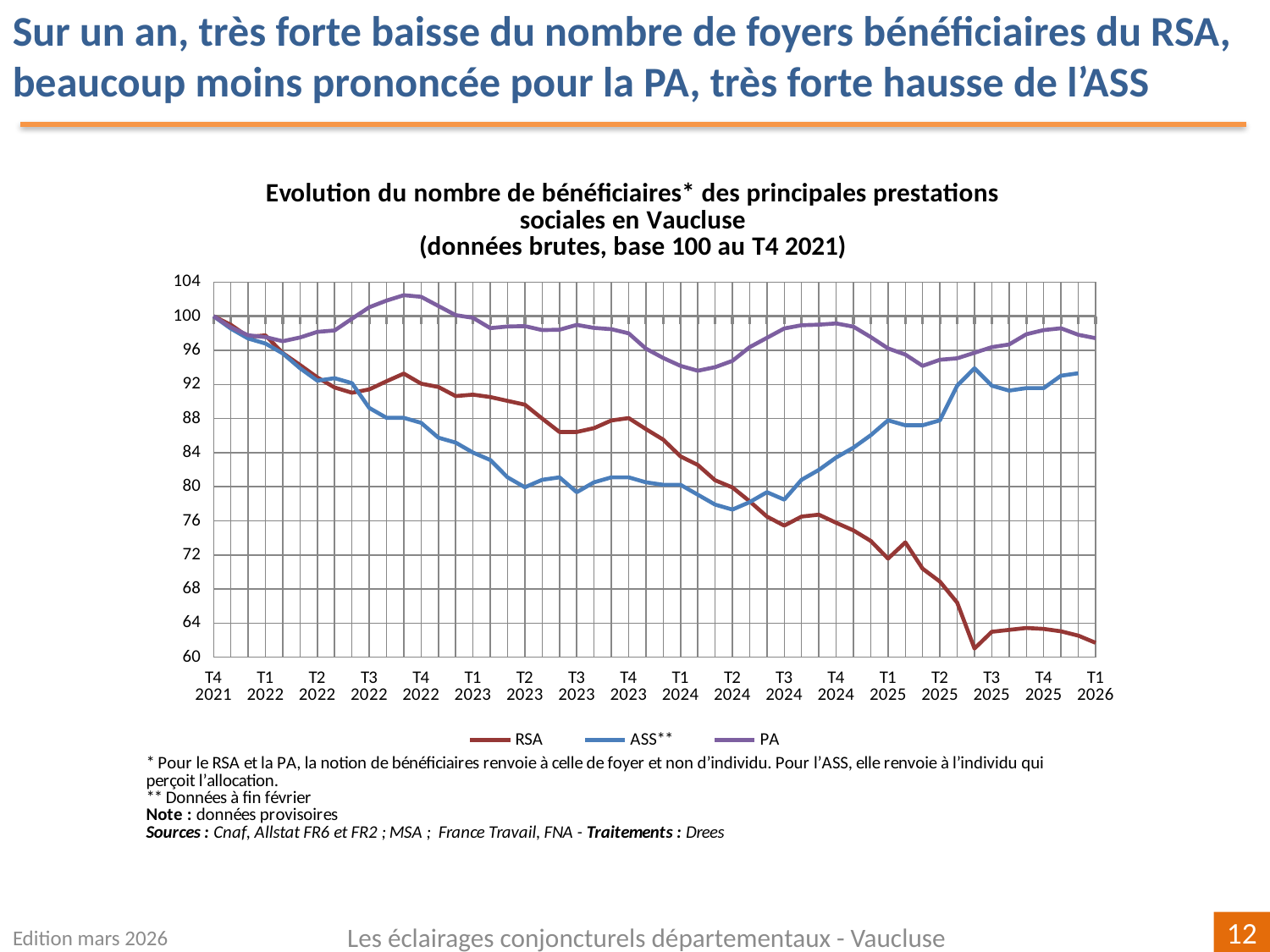
At T1 2026, which series is higher, RSA or PA? PA How many series does the legend list? 3 Which series is the highest at T4 2022? PA What is the value of the RSA series at T4 2021? 100 Which series is the lowest at T1 2026? RSA Is the value for ASS** at T2 2024 greater or less than 80? less Does the RSA series rise or fall overall from T4 2021 to T1 2026? fall What are the three series listed in the legend? RSA, ASS**, PA What kind of chart is shown on the slide? line chart How many quarter labels are shown on the x axis? 18 Is the value for RSA at T1 2026 greater or less than 64? less